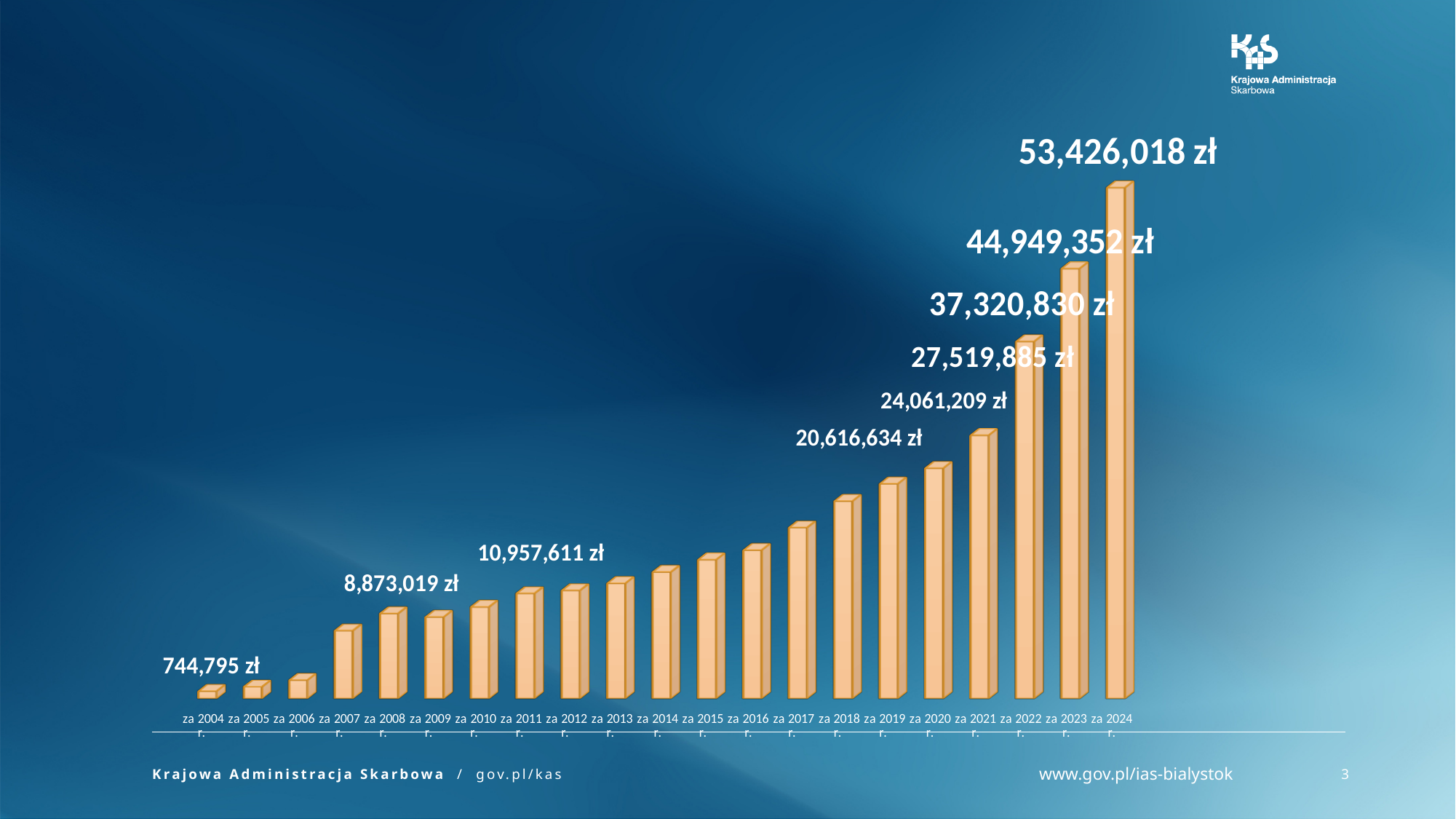
What is the value for za 2023 r.? 44,949,352 zł How many bars (years) are shown in the chart? 21 Do the values generally rise or fall from 2004 to 2024? rise Which year has the lowest value? za 2004 r. What is the value for za 2022 r.? 37,320,830 zł Which is larger, the value for za 2022 r. or za 2021 r.? za 2022 r. What is the difference between the values for za 2024 r. and za 2023 r.? 8,476,666 zł Which year has the highest value? za 2024 r. What is the value for za 2004 r.? 744,795 zł What is the value for za 2008 r.? 8,873,019 zł What is the value for za 2024 r.? 53,426,018 zł What kind of chart is shown on the slide? bar chart